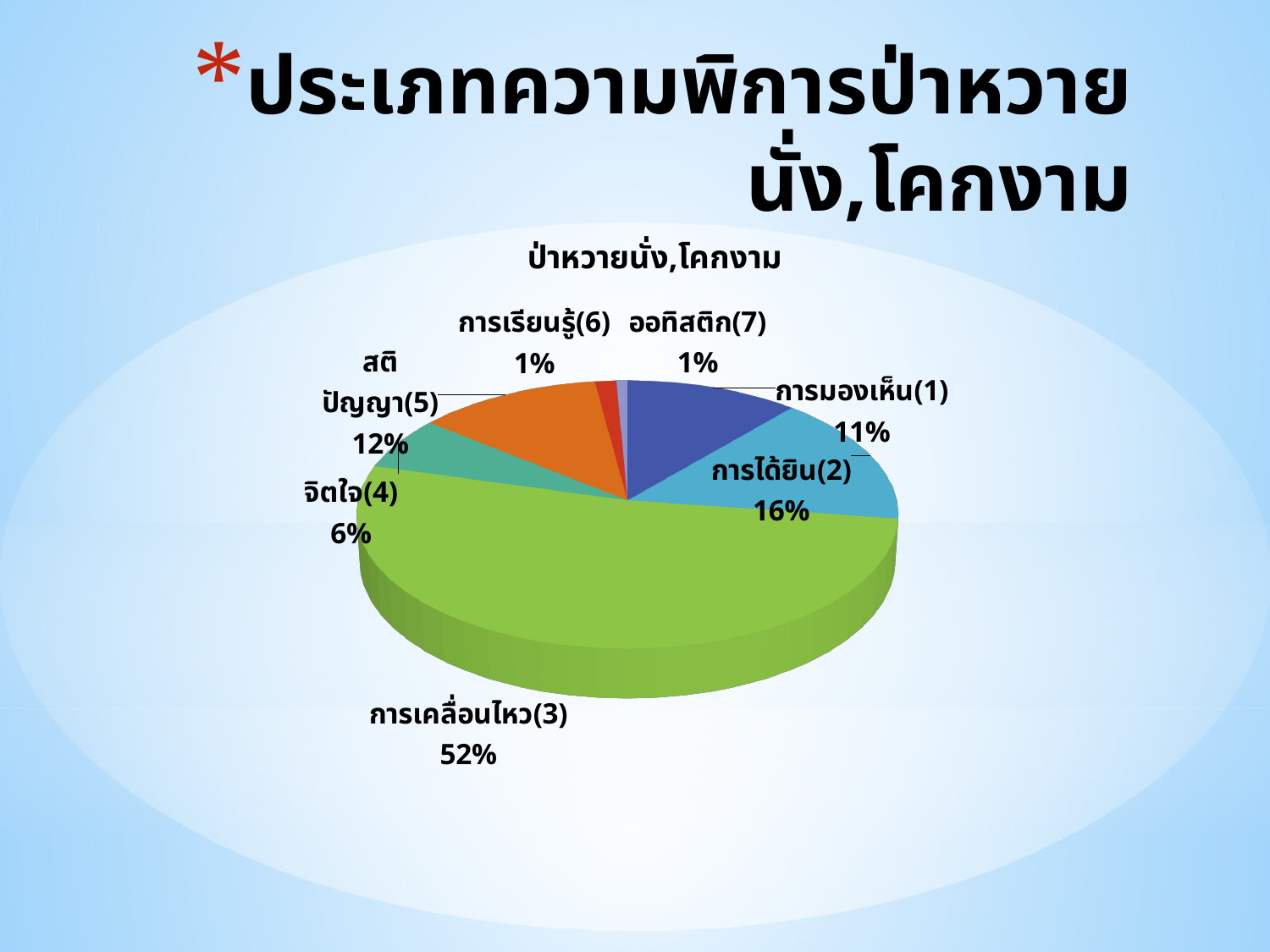
What is the value shown for การได้ยิน(2)? 16% How many categories (slices) does the pie chart have? 7 Which is larger, การได้ยิน(2) or การมองเห็น(1)? การได้ยิน(2) What type of chart is shown on the slide? pie chart What is the value shown for จิตใจ(4)? 6% What is the title of the chart? ป่าหวายนั่ง,โคกงาม What is the difference between the shares of การเคลื่อนไหว(3) and การได้ยิน(2)? 36% Which category has the largest share of the pie? การเคลื่อนไหว(3) What is the value shown for การมองเห็น(1)? 11% What is the value shown for สติปัญญา(5)? 12% What share of the pie does การเคลื่อนไหว(3) represent? 52% What colour is the slice for การเคลื่อนไหว(3)? green